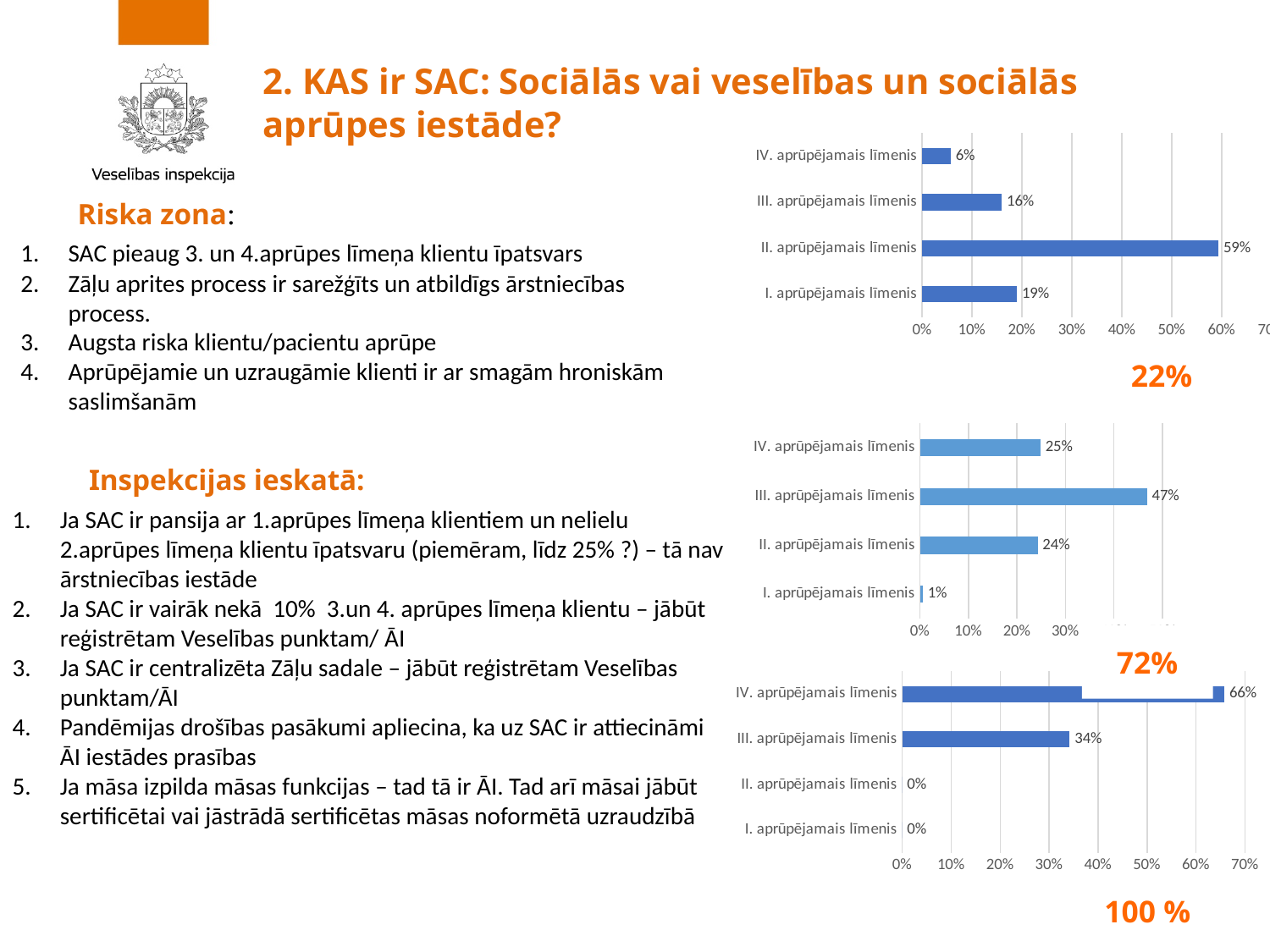
In the bottom chart on the right, what is the difference between the values for IV. aprūpējamais līmenis and III. aprūpējamais līmenis? 32% How many categories are shown in the top chart on the right? 4 In the middle chart on the right, which category has the highest value? III. aprūpējamais līmenis What type of chart is the bottom chart on the right? Bar chart In the top chart on the right, what is the value for II. aprūpējamais līmenis? 59% In the middle chart on the right, which is larger: the value for IV. aprūpējamais līmenis or II. aprūpējamais līmenis? IV. aprūpējamais līmenis In the bottom chart on the right, how many categories have a value of 0%? 2 In the middle chart on the right, what is the value for III. aprūpējamais līmenis? 47% In the middle chart on the right, what is the value for I. aprūpējamais līmenis? 1% In the bottom chart on the right, what is the value for IV. aprūpējamais līmenis? 66% In the top chart on the right, which category has the lowest value? IV. aprūpējamais līmenis In the top chart on the right, what is the difference between the values for I. aprūpējamais līmenis and III. aprūpējamais līmenis? 3%